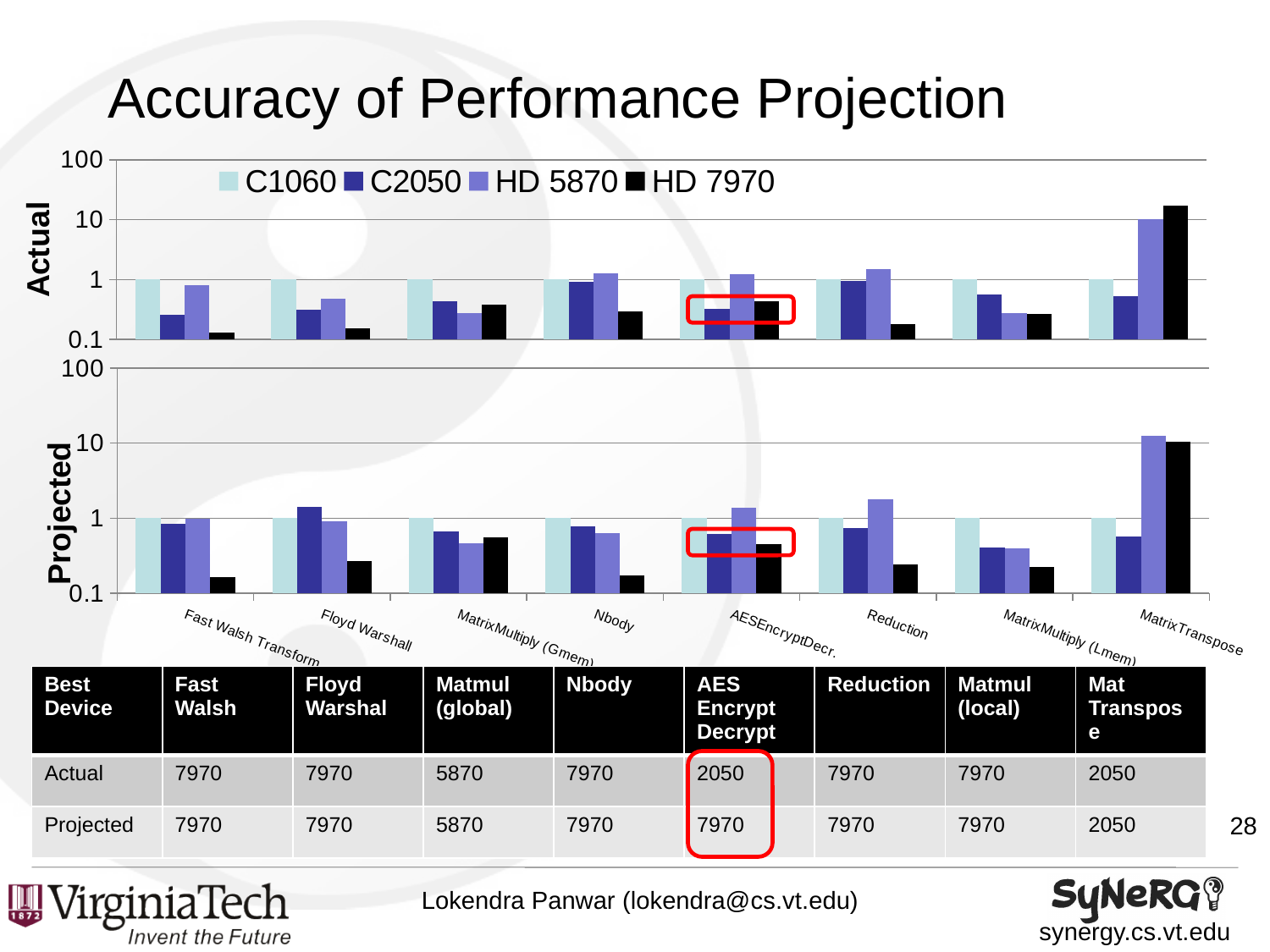
How many series does the legend list for the charts? 4 In the Actual chart, is the value for HD 7970 on MatrixTranspose greater or less than 10? greater What type of chart is the top chart labelled Actual? bar chart In the Projected chart, which category has the highest HD 5870 value? MatrixTranspose How many categories are shown along the x axis of the Projected chart? 8 In the Actual chart, which series has the lowest value for Fast Walsh Transform? HD 7970 What are the four series named in the legend? C1060, C2050, HD 5870, HD 7970 In the Actual chart, for MatrixTranspose, which is larger: HD 7970 or HD 5870? HD 7970 In the Projected chart, is the value for C2050 on Floyd Warshall greater or less than 1? greater In the Projected chart, is the value for HD 5870 on MatrixTranspose greater or less than 10? greater In the Actual chart, which category has the highest HD 7970 value? MatrixTranspose